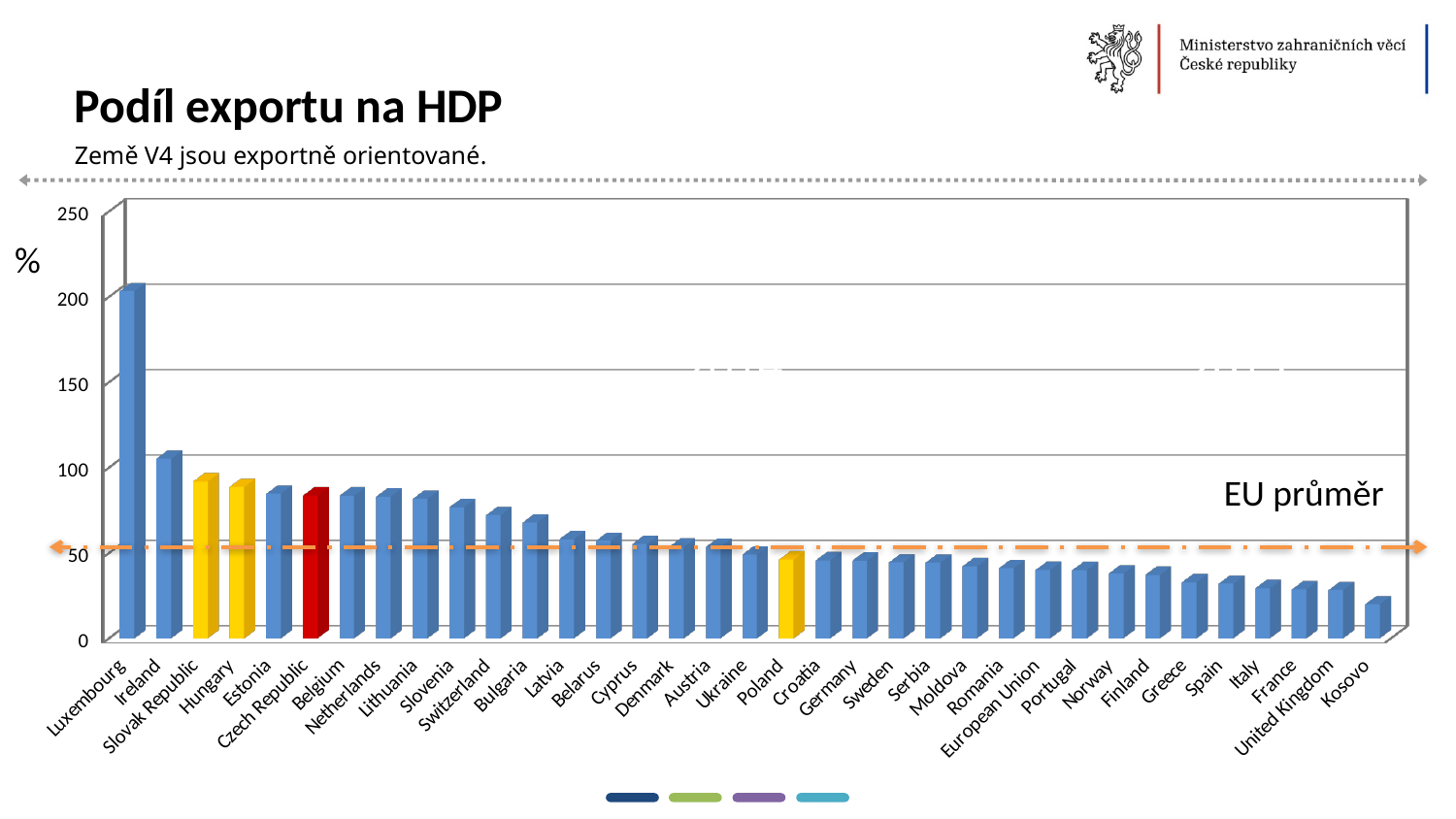
Which has a larger value, Luxembourg or Ireland? Luxembourg Which has a larger value, Estonia or Kosovo? Estonia How many countries/categories are shown on the x axis? 35 What does the orange dashed horizontal line represent? EU průměr Which country has the highest export share of GDP in the chart? Luxembourg Which country has the lowest export share of GDP in the chart? Kosovo What kind of chart is shown on the slide? bar chart Do the bar values rise or fall from left to right along the x axis? fall Is the value for Kosovo greater or less than 50? less Is the value for Czech Republic greater or less than 50? greater Is the value for Luxembourg greater or less than 150? greater